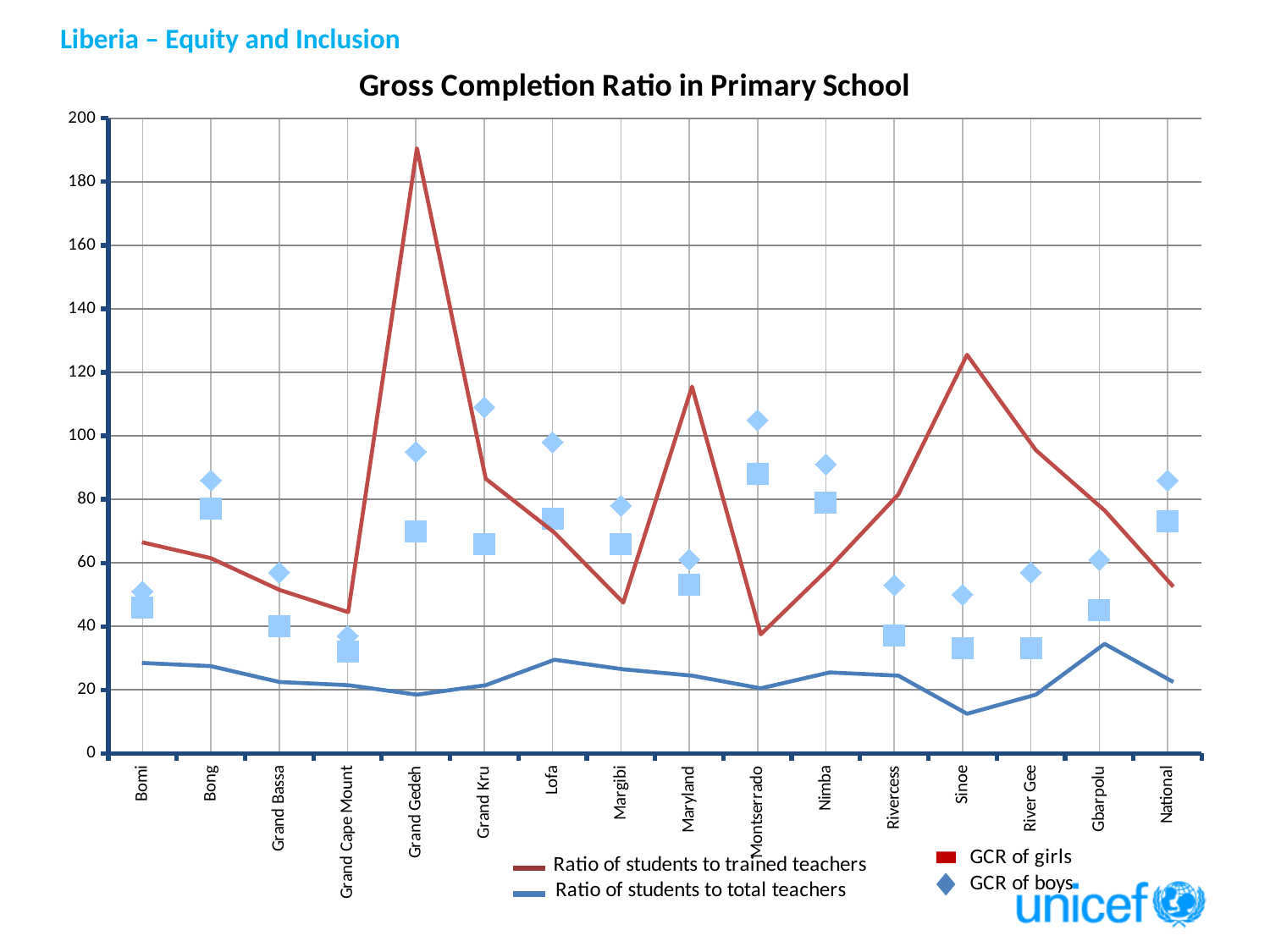
Does the ratio of students to total teachers rise or fall from Bomi to Grand Gedeh? fall What kind of chart is this? Line chart Is the ratio of students to trained teachers for Grand Gedeh greater or less than 180? greater Which category has the highest ratio of students to trained teachers? Grand Gedeh Is the GCR of girls for Bomi greater or less than 60? less Is the GCR of boys for Montserrado greater or less than 100? greater Which category has the highest GCR of boys? Grand Kru Which has the larger ratio of students to trained teachers, Grand Gedeh or Maryland? Grand Gedeh Which category has the lowest ratio of students to total teachers? Sinoe How many categories are shown along the x axis? 16 How many series does the legend list? 4 What is the title of the chart? Gross Completion Ratio in Primary School